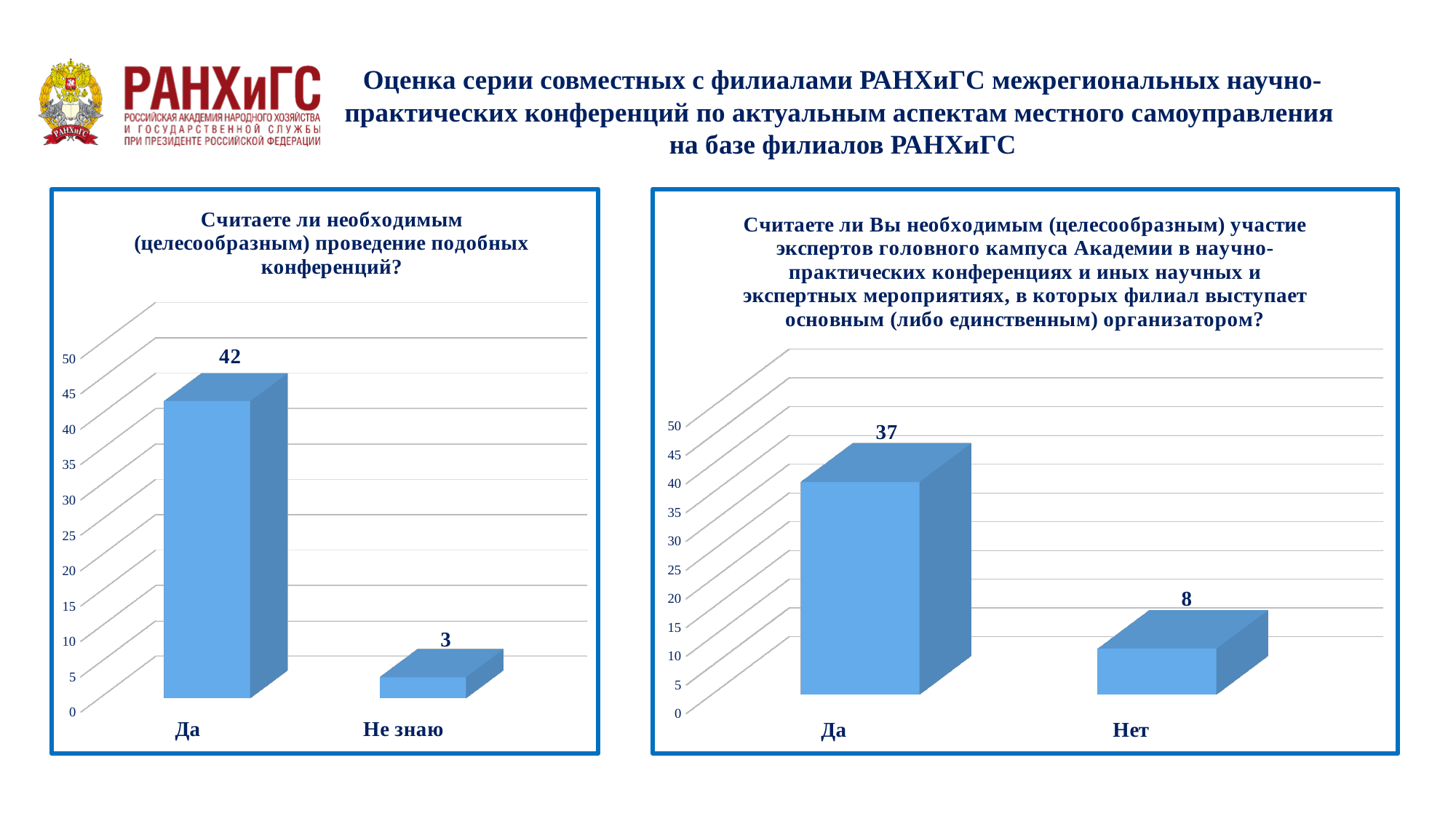
In the left chart, what is the value for "Да"? 42 What kind of chart is the right chart? Bar chart In the left chart, what is the difference between the values for "Да" and "Не знаю"? 39 In the right chart, which is larger: the value for "Да" or the value for "Нет"? Да In the right chart, which category has the lowest value? Нет In the right chart, what is the value for "Нет"? 8 In the left chart, which category has the highest value? Да In the left chart, what is the total of the two plotted values? 45 In the right chart, what is the value for "Да"? 37 In the right chart, what is the difference between the values for "Да" and "Нет"? 29 How many categories does the left chart show? 2 In the left chart, what is the value for "Не знаю"? 3